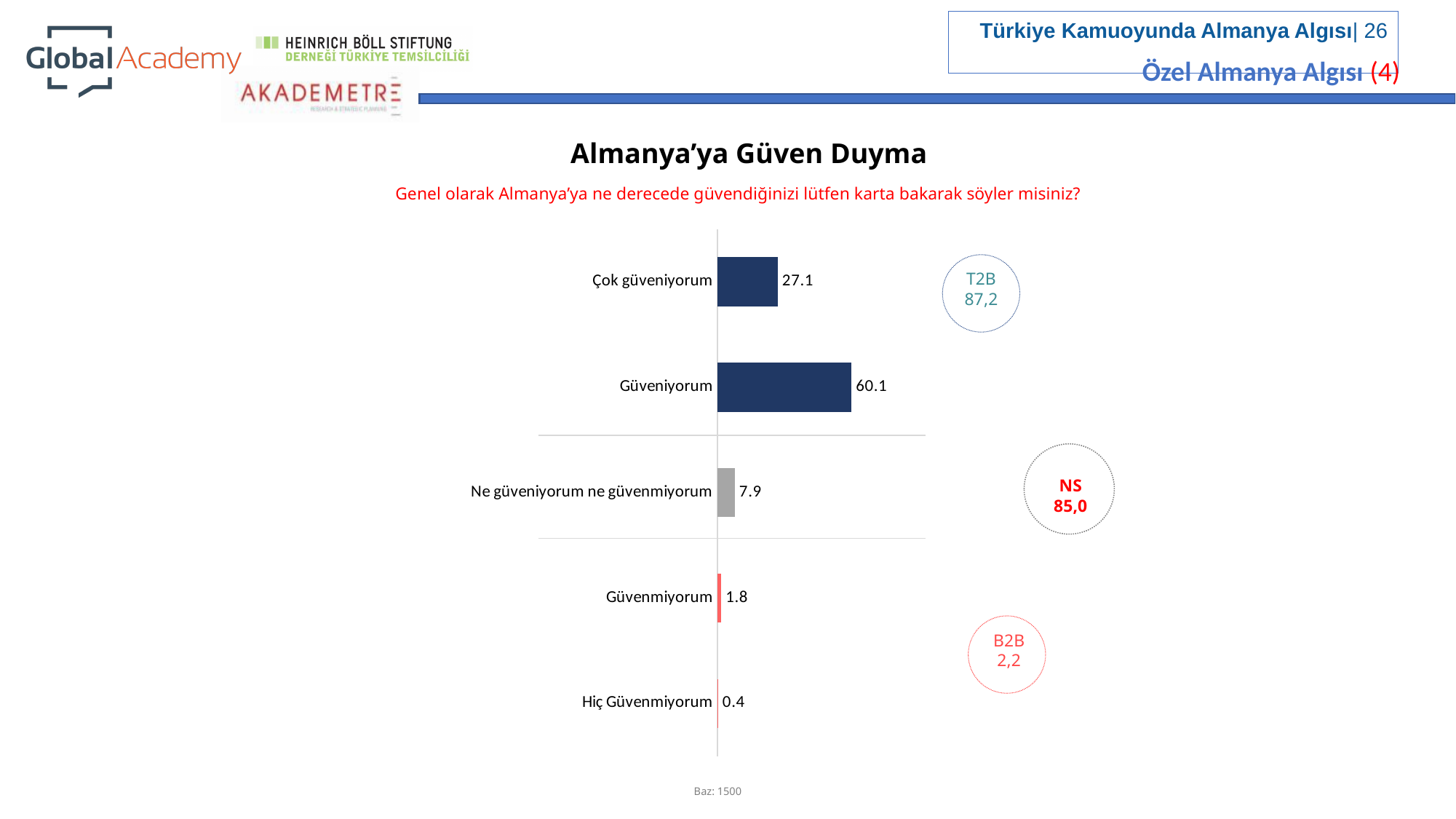
How many categories are shown in the chart? 5 Which category has the highest value? Güveniyorum Which category has the lowest value? Hiç Güvenmiyorum Which is larger, the value for "Güvenmiyorum" or the value for "Ne güveniyorum ne güvenmiyorum"? Ne güveniyorum ne güvenmiyorum What kind of chart is shown on the slide? Bar chart What is the value for "Ne güveniyorum ne güvenmiyorum"? 7.9 What is the value for "Çok güveniyorum"? 27.1 What is the T2B value shown next to the chart? 87,2 What is the value for "Hiç Güvenmiyorum"? 0.4 What is the title of the chart? Almanya'ya Güven Duyma What is the value for "Güveniyorum"? 60.1 What is the difference between the values for "Güveniyorum" and "Çok güveniyorum"? 33.0